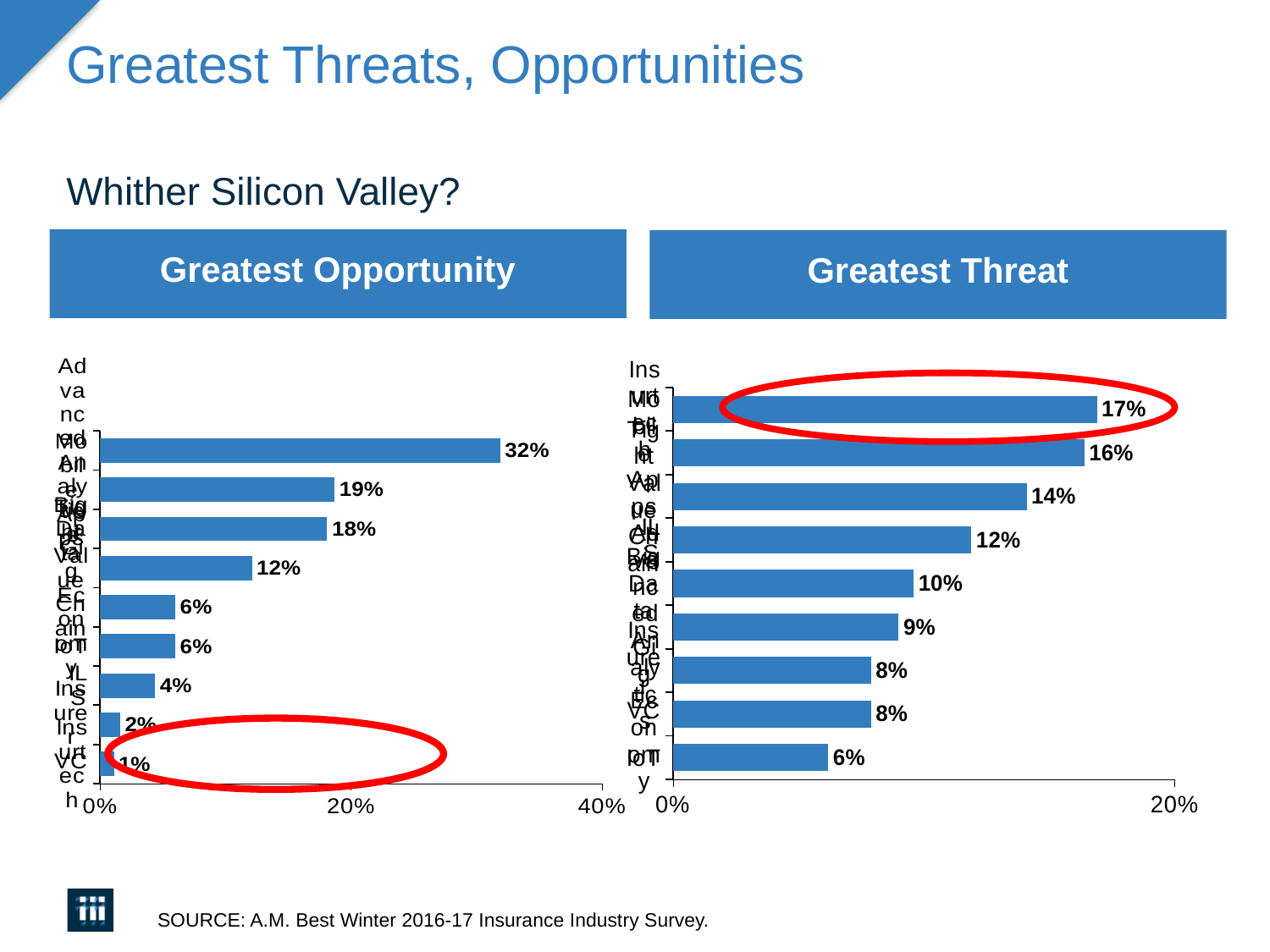
In the Greatest Opportunity chart, what is the lowest value shown? 1% In the Greatest Threat chart, what is the lowest value shown? 6% In the Greatest Threat chart, how many bars are plotted? 9 In the Greatest Opportunity chart, how many bars are plotted? 9 In the Greatest Opportunity chart, what is the difference between the highest value (32%) and the second-highest value (19%)? 13% In the Greatest Opportunity chart, what value is shown for the bar circled in red at the bottom? 1% Which is larger: the highest value in the Greatest Opportunity chart or the highest value in the Greatest Threat chart? Greatest Opportunity (32%) In the Greatest Threat chart, what is the difference between the top bar (17%) and the bottom bar (6%)? 11% In the Greatest Opportunity chart, what is the highest value shown? 32% What is the maximum value shown on the x axis of the Greatest Threat chart? 20% What kind of chart is the Greatest Opportunity chart? Bar chart In the Greatest Threat chart, what is the highest value shown? 17%